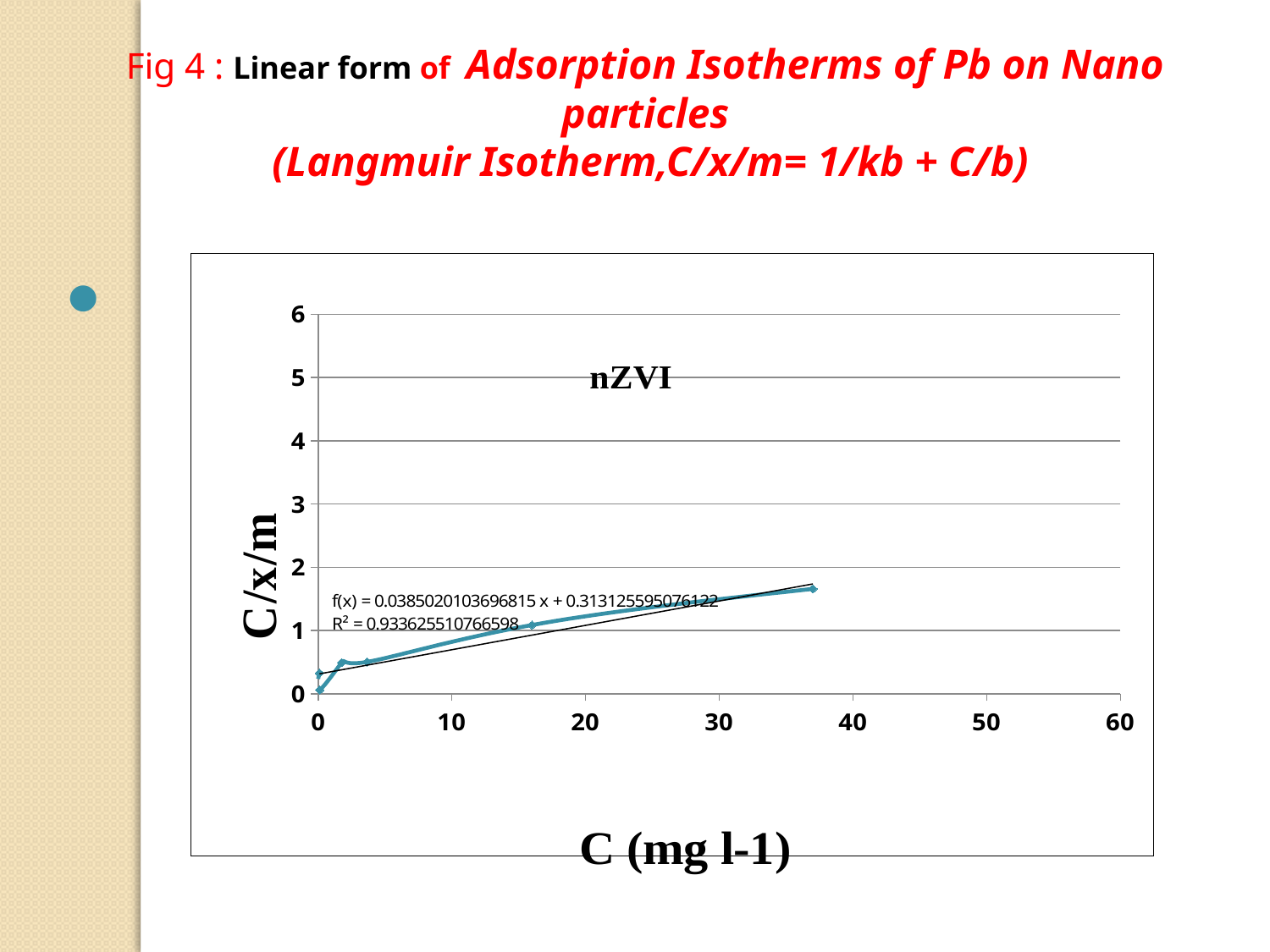
Is the C/x/m value at the rightmost data point (C near 37) greater or less than 1? greater What is the intercept of the fitted line f(x) printed on the chart? 0.313125595076122 What is the slope of the fitted line f(x) printed on the chart? 0.0385020103696815 Do the plotted C/x/m values generally rise or fall as C increases along the x axis? rise What is the R² value printed on the chart? 0.933625510766598 Is the C/x/m value at the data point near C = 4 greater or less than 1? less What is the label on the y axis of the chart? C/x/m What kind of chart is shown on the slide? line chart What is the label on the x axis of the chart? C (mg l-1) Is the C/x/m value at the rightmost data point (C near 37) greater or less than 2? less Which data point has the highest C/x/m value: the one near C = 16 or the one near C = 37? the one near C = 37 What is the highest value shown on the x axis? 60